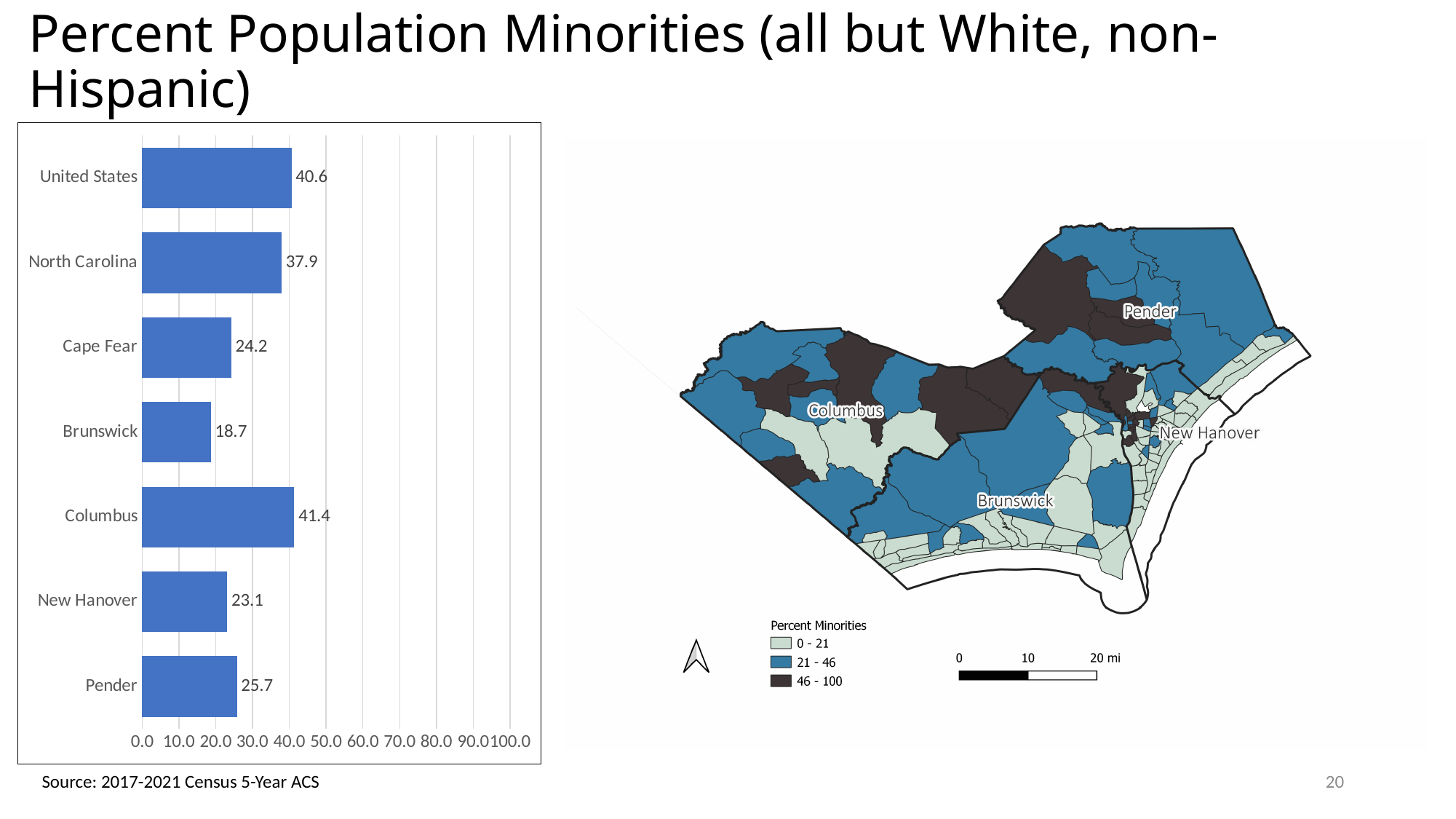
In the bar chart, what is the value shown for Pender? 25.7 How many classes does the map legend for Percent Minorities list? 3 How many categories are shown in the bar chart? 7 In the bar chart, what is the percent population minorities for North Carolina? 37.9 In the bar chart, what is the difference between the values for Columbus and Brunswick? 22.7 In the bar chart, what is the value shown for New Hanover? 23.1 In the bar chart, is the value for Brunswick greater or less than 20.0? less In the bar chart, which is larger, the value for Cape Fear or the value for New Hanover? Cape Fear What kind of chart is shown on the left of the slide? bar chart In the bar chart, what is the difference between the values for United States and North Carolina? 2.7 In the bar chart, which category has the highest value? Columbus In the bar chart, which category has the lowest value? Brunswick